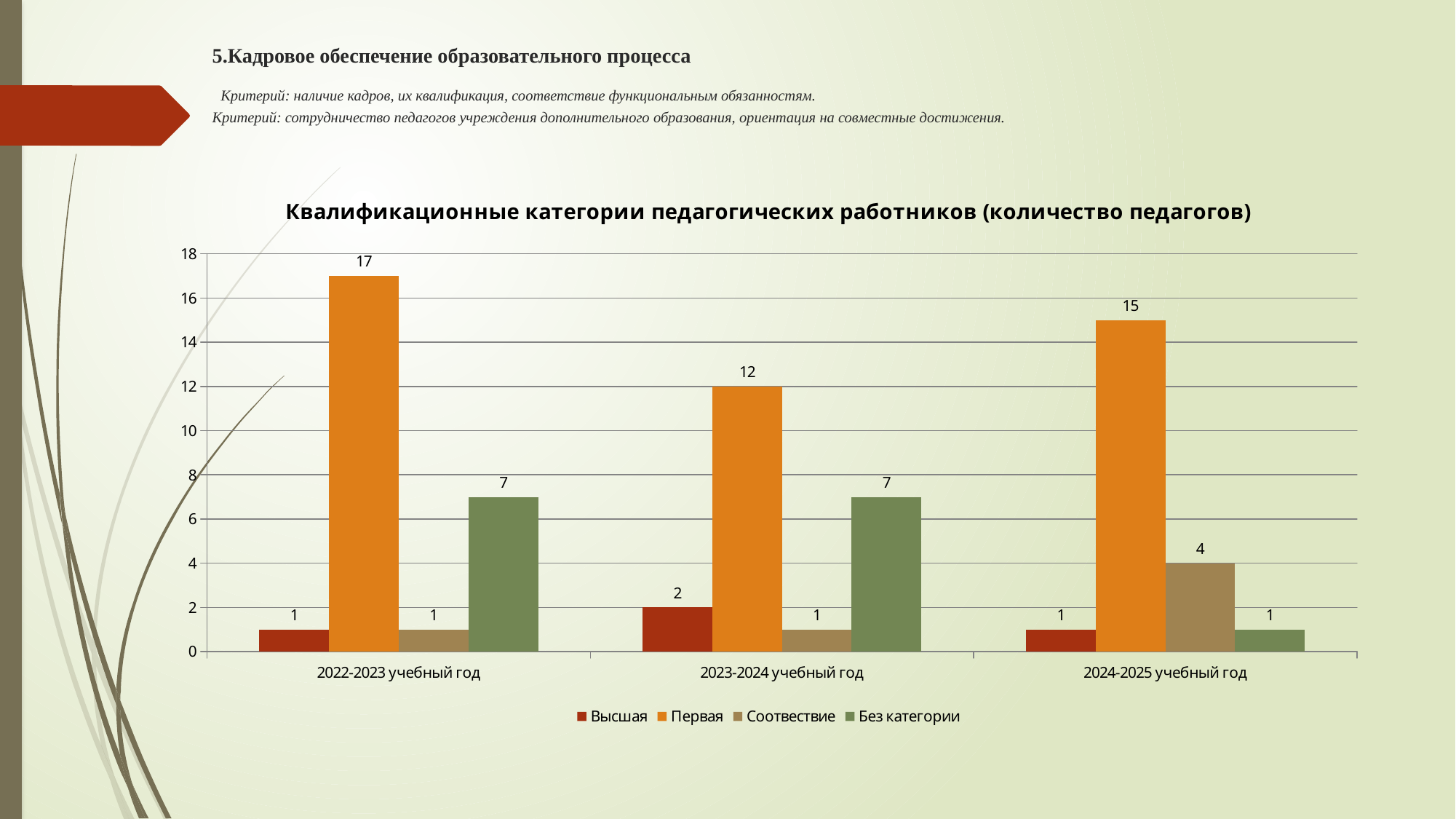
What is the title of the chart? Квалификационные категории педагогических работников (количество педагогов) What kind of chart is shown on the slide? Bar chart What is the value for Без категории in 2024-2025 учебный год? 1 How many year categories are shown on the x axis? 3 What is the difference between the Первая values for 2022-2023 учебный год and 2024-2025 учебный год? 2 What is the value for Первая in 2022-2023 учебный год? 17 Which is larger: Без категории in 2023-2024 учебный год or Соотвествие in 2024-2025 учебный год? Без категории in 2023-2024 учебный год In which year is the value for Первая the lowest? 2023-2024 учебный год In which year is the value for Первая the highest? 2022-2023 учебный год What is the value for Соотвествие in 2024-2025 учебный год? 4 What is the value for Высшая in 2023-2024 учебный год? 2 How many series does the legend list? 4